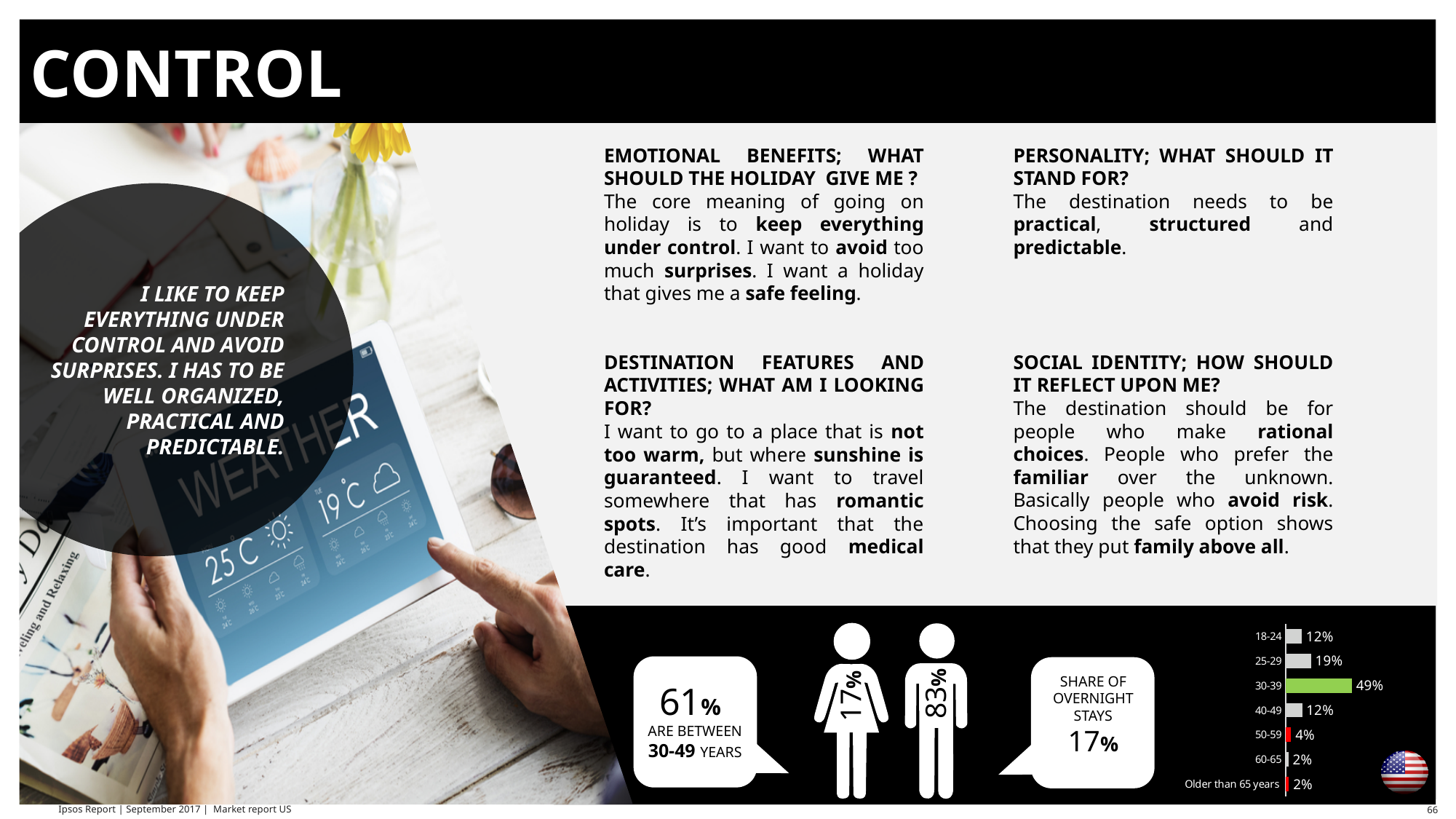
In the age bar chart at the bottom right, what is the difference between the values for 30-39 and 25-29? 30% In the age bar chart at the bottom right, what is the value for the 50-59 age group? 4% In the age bar chart at the bottom right, which is larger: the value for 50-59 or the value for 60-65? 50-59 What kind of chart is shown at the bottom right of the slide? Bar chart In the age bar chart at the bottom right, what is the value for the 'Older than 65 years' group? 2% In the age bar chart at the bottom right, which age group has the highest value? 30-39 How many age categories are shown in the bar chart at the bottom right? 7 In the age bar chart at the bottom right, which is larger: the value for 25-29 or the value for 40-49? 25-29 In the age bar chart at the bottom right, what is the value for the 30-39 age group? 49% In the age bar chart at the bottom right, which bar is coloured green? 30-39 In the age bar chart at the bottom right, what is the difference between the values for 18-24 and 50-59? 8% In the age bar chart at the bottom right, what is the value for the 25-29 age group? 19%